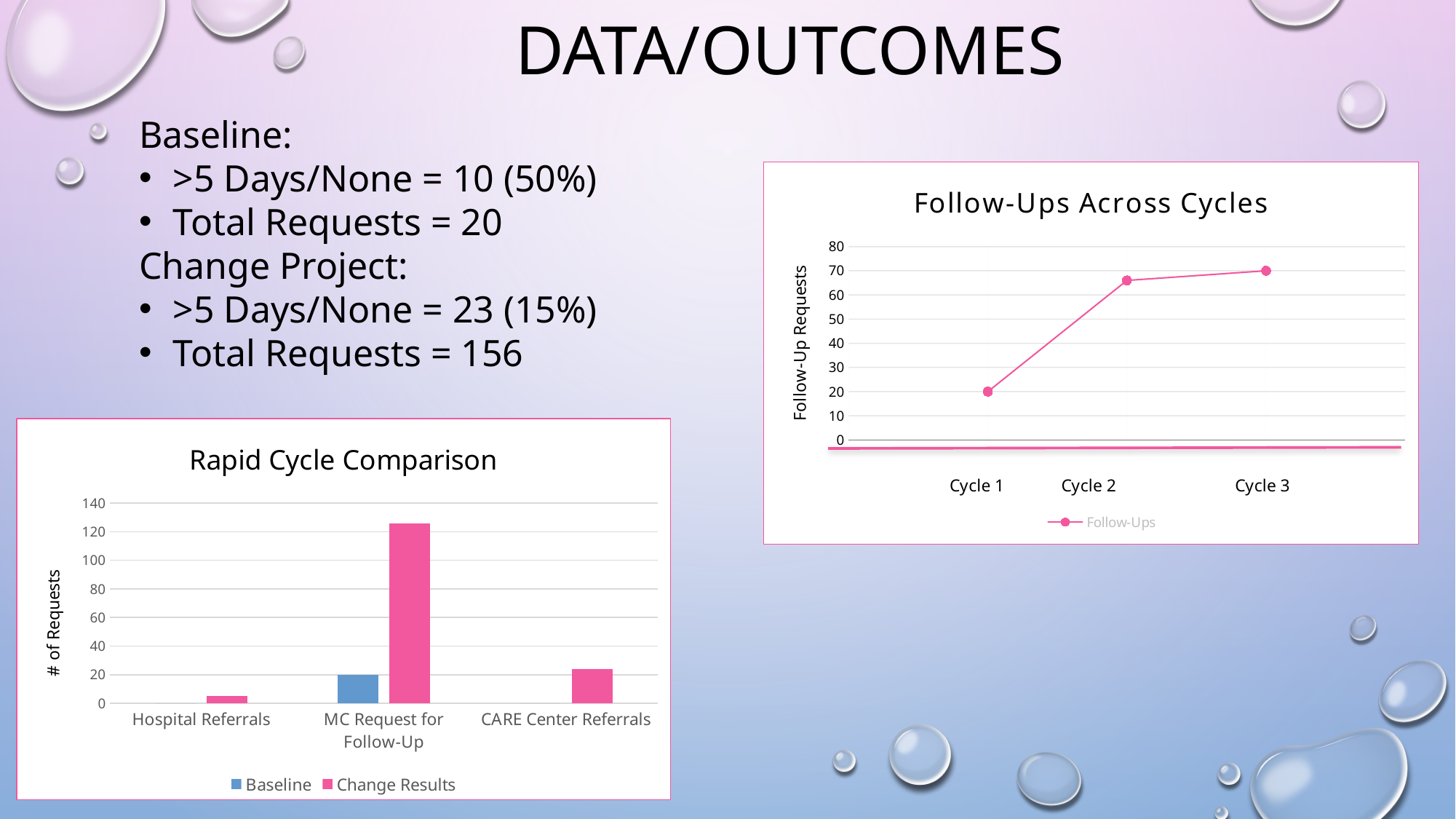
In the 'Rapid Cycle Comparison' chart, is the Change Results value for Hospital Referrals greater or less than 20? less What type of chart is the 'Rapid Cycle Comparison' chart? bar chart In the 'Rapid Cycle Comparison' chart, which is larger for MC Request for Follow-Up: Baseline or Change Results? Change Results In the 'Follow-Ups Across Cycles' chart, which cycle has the lowest number of follow-up requests? Cycle 1 In the 'Rapid Cycle Comparison' chart, which category has the highest Change Results value? MC Request for Follow-Up In the 'Rapid Cycle Comparison' chart, how many series does the legend list? 2 What type of chart is the 'Follow-Ups Across Cycles' chart? line chart In the 'Follow-Ups Across Cycles' chart, do the follow-up values rise or fall from Cycle 1 to Cycle 3? rise In the 'Rapid Cycle Comparison' chart, is the Change Results value for MC Request for Follow-Up greater or less than 120? greater In the 'Follow-Ups Across Cycles' chart, how many cycles are plotted on the x axis? 3 In the 'Follow-Ups Across Cycles' chart, what is the Follow-Ups value for Cycle 3? 70 In the 'Rapid Cycle Comparison' chart, how many categories are shown on the x axis? 3